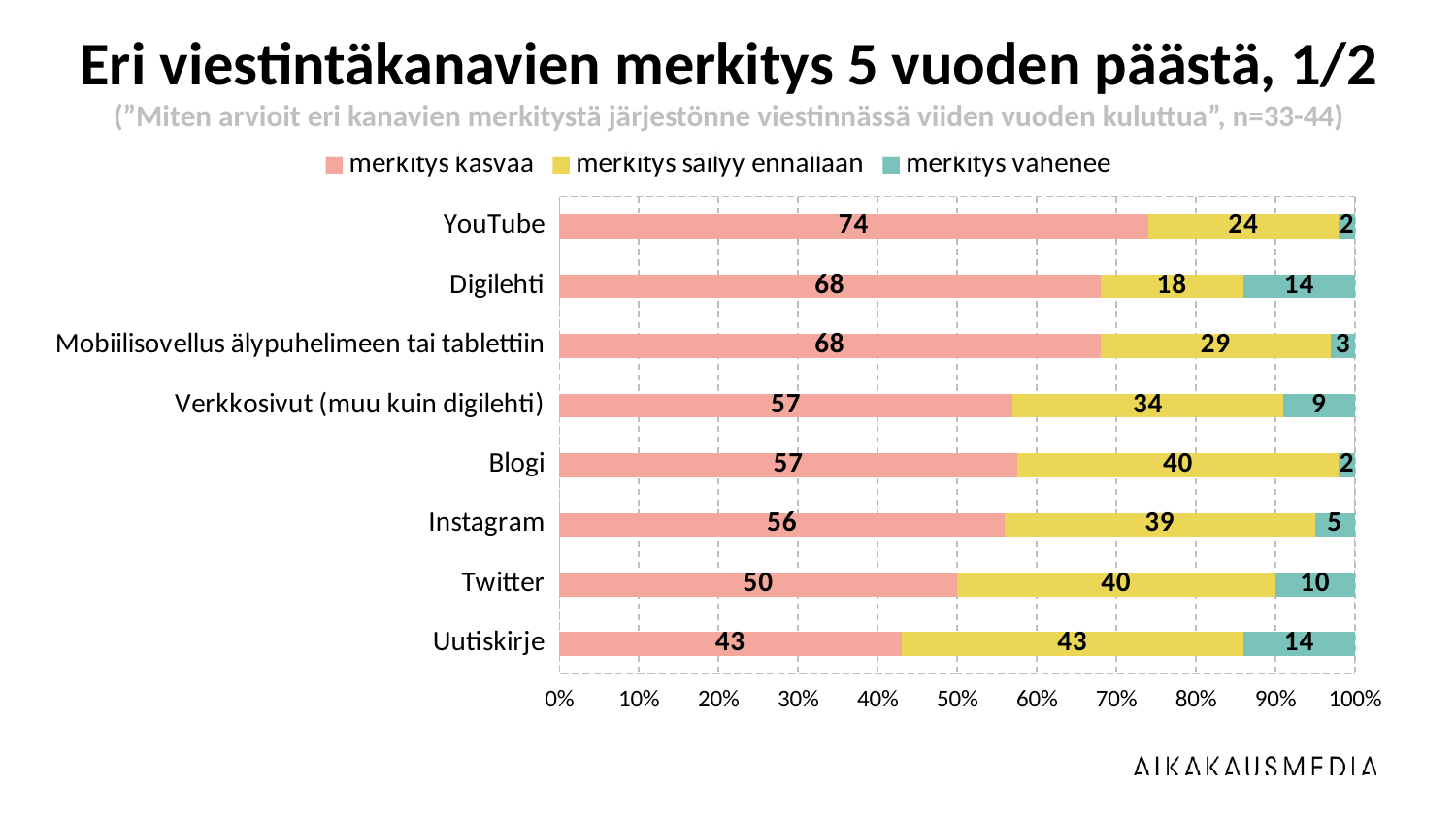
How many categories are shown on the chart? 8 Which category has the lowest value for "merkitys kasvaa"? Uutiskirje What is the value of "merkitys kasvaa" for YouTube? 74 What is the value of "merkitys säilyy ennallaan" for Blogi? 40 What kind of chart is shown on the slide? Stacked bar chart What is the total of the stacked bar for Uutiskirje? 100 How many series does the legend list? 3 Which is larger: the "merkitys säilyy ennallaan" value for Instagram or for Verkkosivut (muu kuin digilehti)? Instagram Which series is shown in yellow? merkitys säilyy ennallaan What is the difference between the "merkitys kasvaa" values for YouTube and Twitter? 24 Which category has the highest value for "merkitys kasvaa"? YouTube What is the value of "merkitys vähenee" for Digilehti? 14